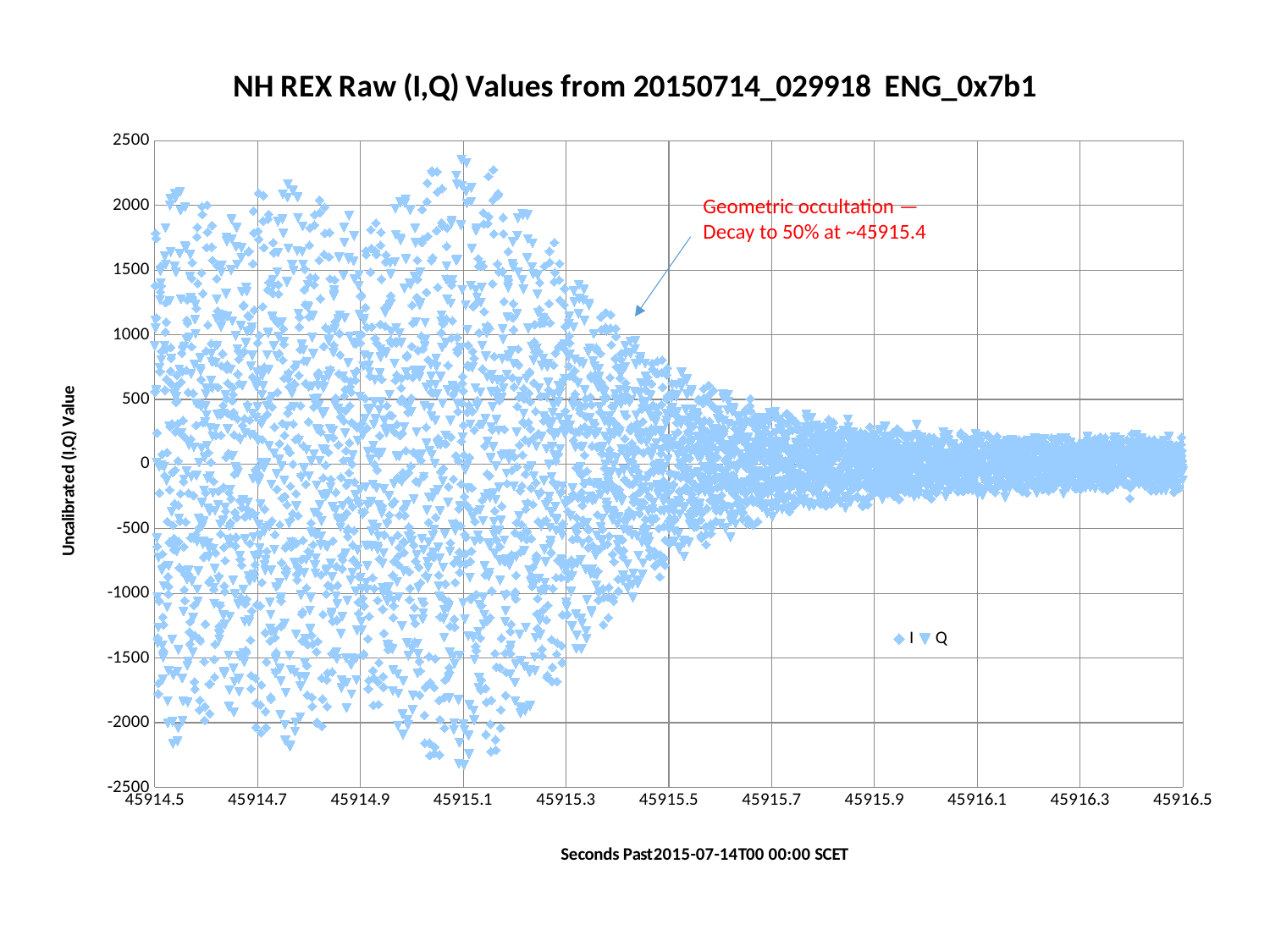
What is the minimum value shown on the y axis? -2500 What is the label of the x axis? Seconds Past 2015-07-14T00 00:00 SCET What is the last tick value on the x axis? 45916.5 What is the label of the y axis? Uncalibrated (I,Q) Value Does the spread of the plotted (I,Q) values increase or decrease as the x axis moves from 45914.5 to 45916.5? decrease What are the two series named in the legend? I and Q What kind of chart is shown on the slide? scatter plot What is the maximum value shown on the y axis? 2500 According to the annotation, at approximately what x value does the signal decay to 50%? ~45915.4 How many series does the legend list? 2 What is the title of the chart? NH REX Raw (I,Q) Values from 20150714_029918 ENG_0x7b1 What is the first tick value on the x axis? 45914.5